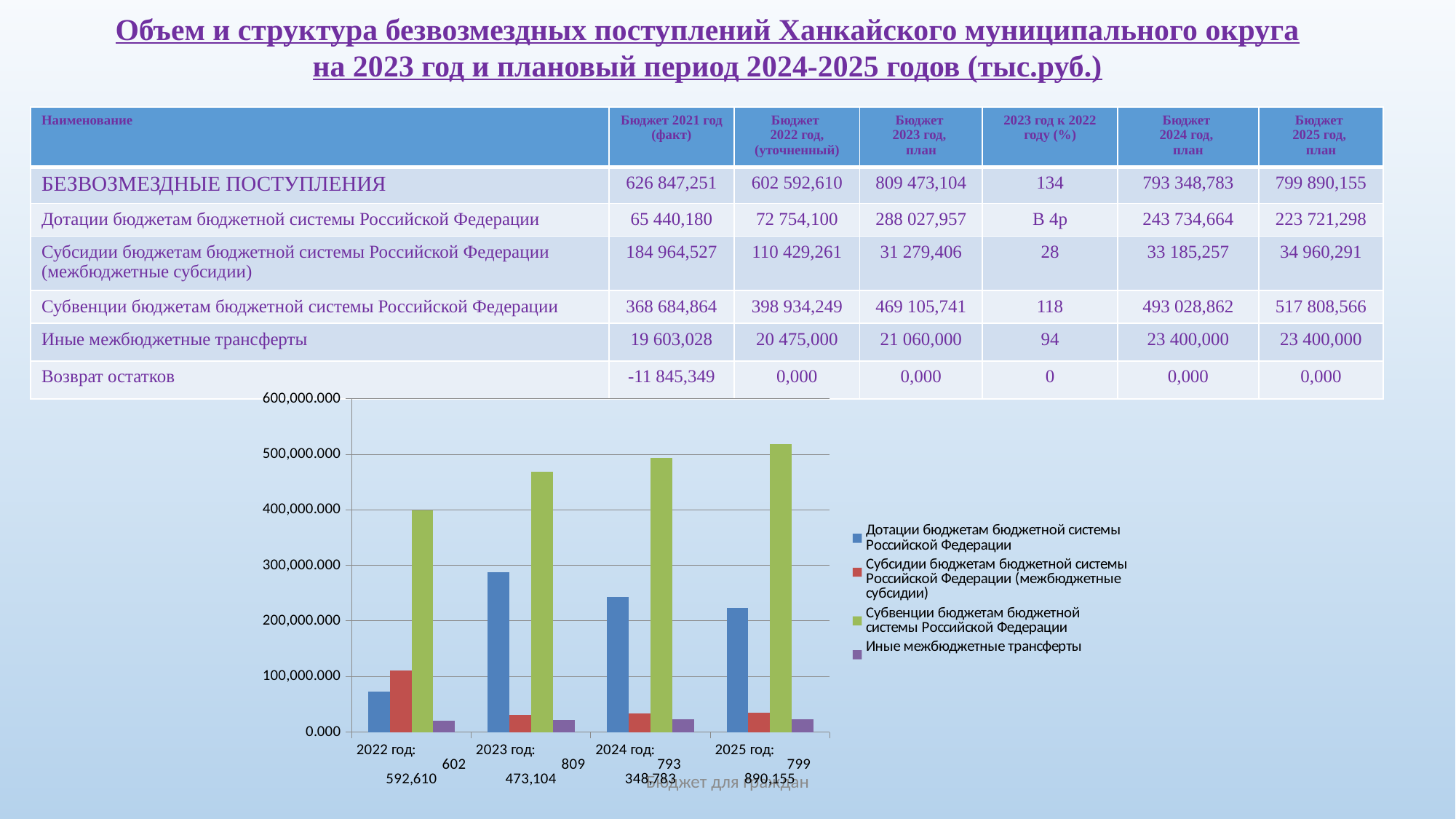
Which is larger: the Дотации bar for 2023 год or the Дотации bar for 2024 год? 2023 год What colour represents Субвенции бюджетам бюджетной системы Российской Федерации in the chart legend? green Is the bar for Субвенции бюджетам бюджетной системы Российской Федерации in 2025 год greater or less than 500,000.000? greater Which series has the shortest bar in the 2024 год group? Иные межбюджетные трансферты How many series does the chart legend list? 4 In the 2022 год group, which bar is taller: Дотации or Субсидии? Субсидии How many year categories are shown on the x axis of the chart? 4 Is the bar for Дотации бюджетам бюджетной системы Российской Федерации in 2023 год greater or less than 300,000.000? less What kind of chart is shown on the slide? bar chart Which series has the tallest bar in the 2025 год group? Субвенции бюджетам бюджетной системы Российской Федерации Do the bars for Субвенции бюджетам бюджетной системы Российской Федерации rise or fall from 2022 год to 2025 год? rise Is the bar for Дотации бюджетам бюджетной системы Российской Федерации in 2022 год greater or less than 100,000.000? less